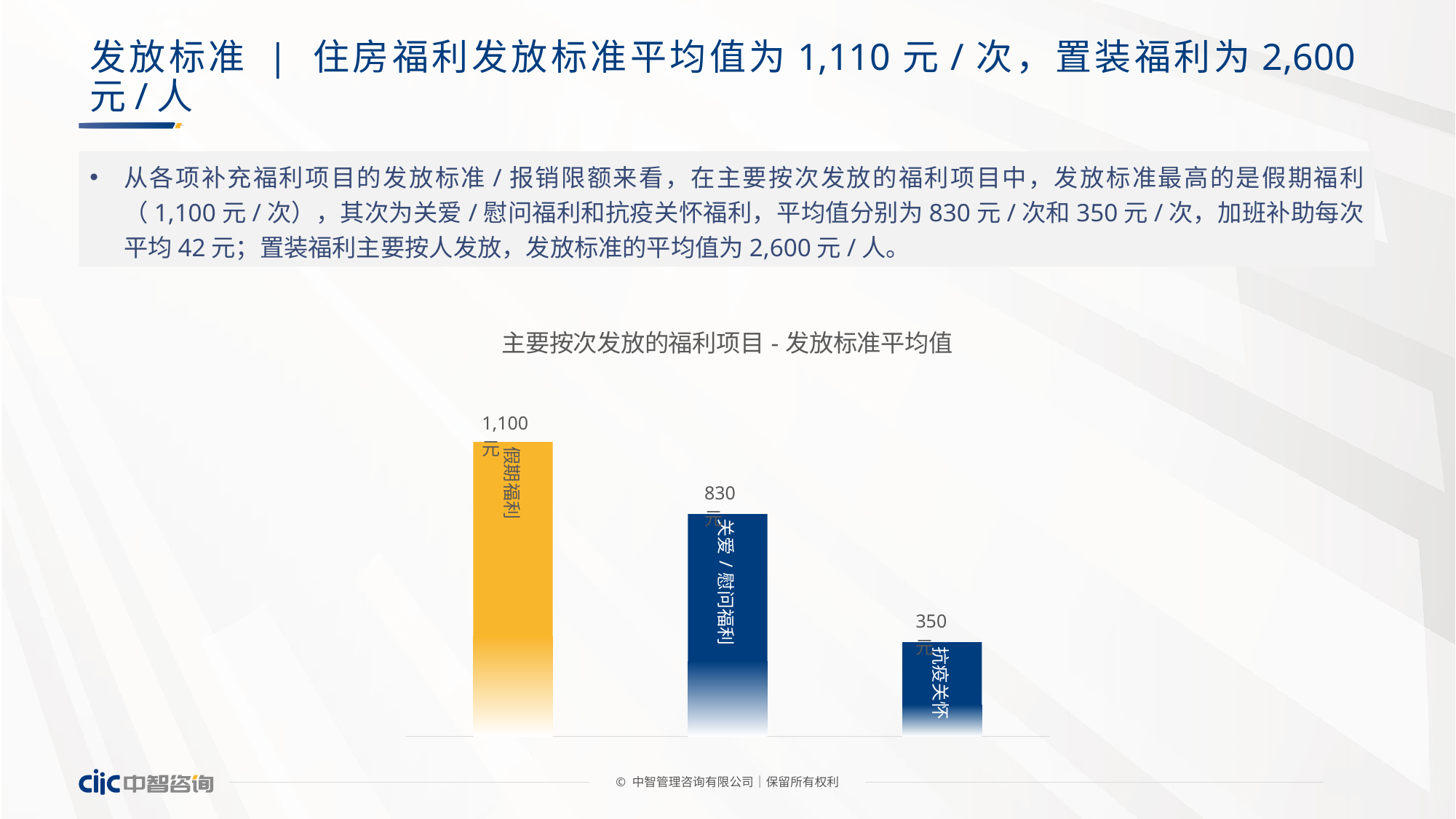
Do the values rise or fall from left to right across the bars? Fall What is the average issuance standard for 抗疫关怀 in the chart? 350 元 What is the average issuance standard for 关爱 / 慰问福利 in the chart? 830 元 What kind of chart is shown on the slide? Bar chart What is the title of the chart? 主要按次发放的福利项目 - 发放标准平均值 How many benefit items are plotted in the chart? 3 Which benefit item has the lowest average issuance standard in the chart? 抗疫关怀 Which benefit item has the highest average issuance standard in the chart? 假期福利 Which is larger, the value for 关爱 / 慰问福利 or the value for 抗疫关怀? 关爱 / 慰问福利 What is the difference between the values for 关爱 / 慰问福利 and 抗疫关怀? 480 元 What is the average issuance standard for 假期福利 in the chart? 1,100 元 What is the difference between the values for 假期福利 and 关爱 / 慰问福利? 270 元